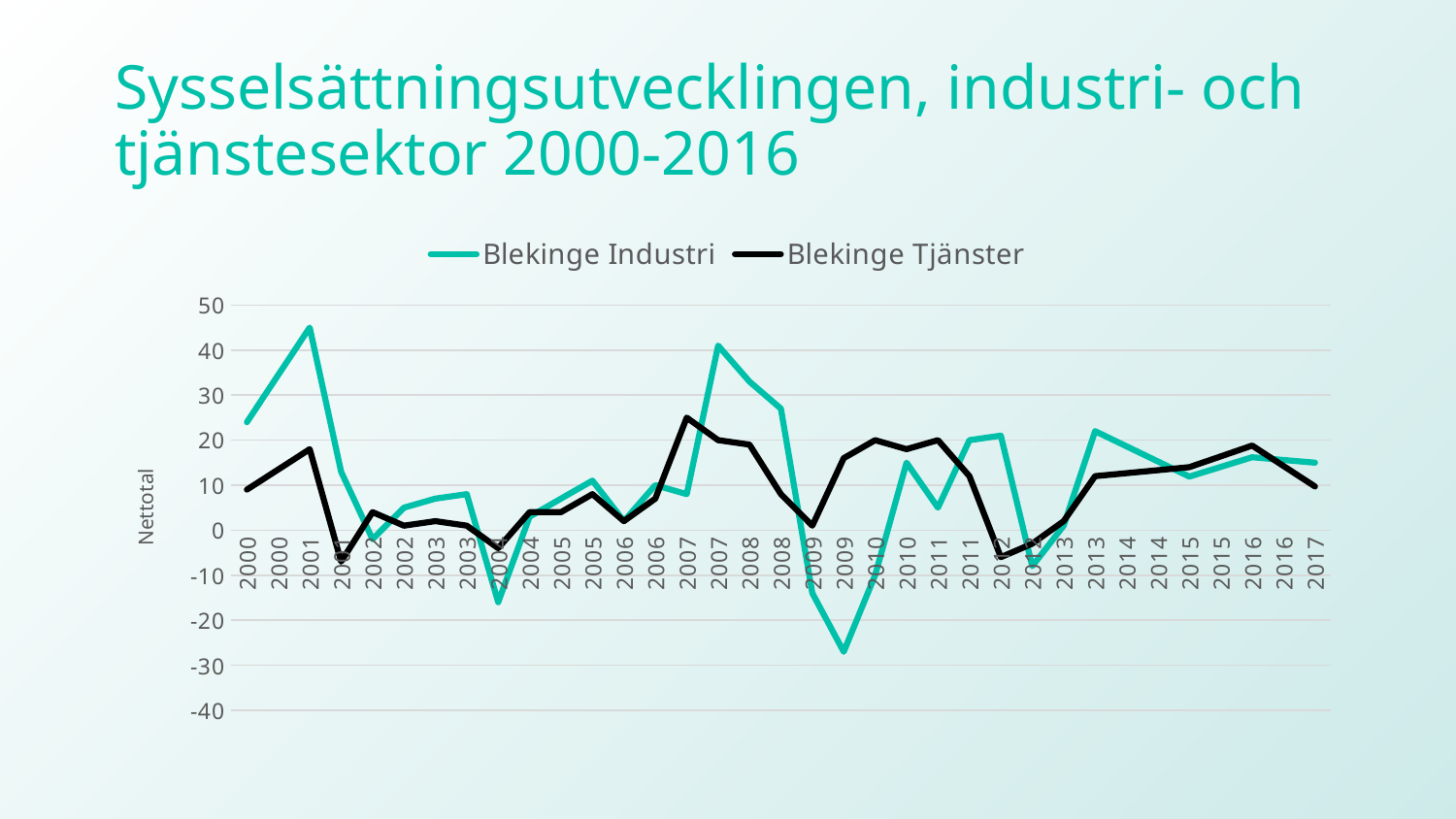
Is the highest value of Blekinge Tjänster (in 2007) greater or less than 30? less At the 2001 peak, which series has the larger value, Blekinge Industri or Blekinge Tjänster? Blekinge Industri What kind of chart is shown on the slide? line chart Which series reaches the lowest value on the chart? Blekinge Industri Which series reaches the highest value on the chart? Blekinge Industri How many series does the legend list? 2 What is the title of the chart? Sysselsättningsutvecklingen, industri- och tjänstesektor 2000-2016 Does the Blekinge Industri line rise or fall between its 2001 peak and 2002? fall What is the label on the vertical axis? Nettotal Is the peak value of Blekinge Industri in 2001 greater or less than 40? greater At the low point in 2009, which series has the larger value, Blekinge Industri or Blekinge Tjänster? Blekinge Tjänster Is the lowest value of Blekinge Industri in 2009 greater or less than -20? less